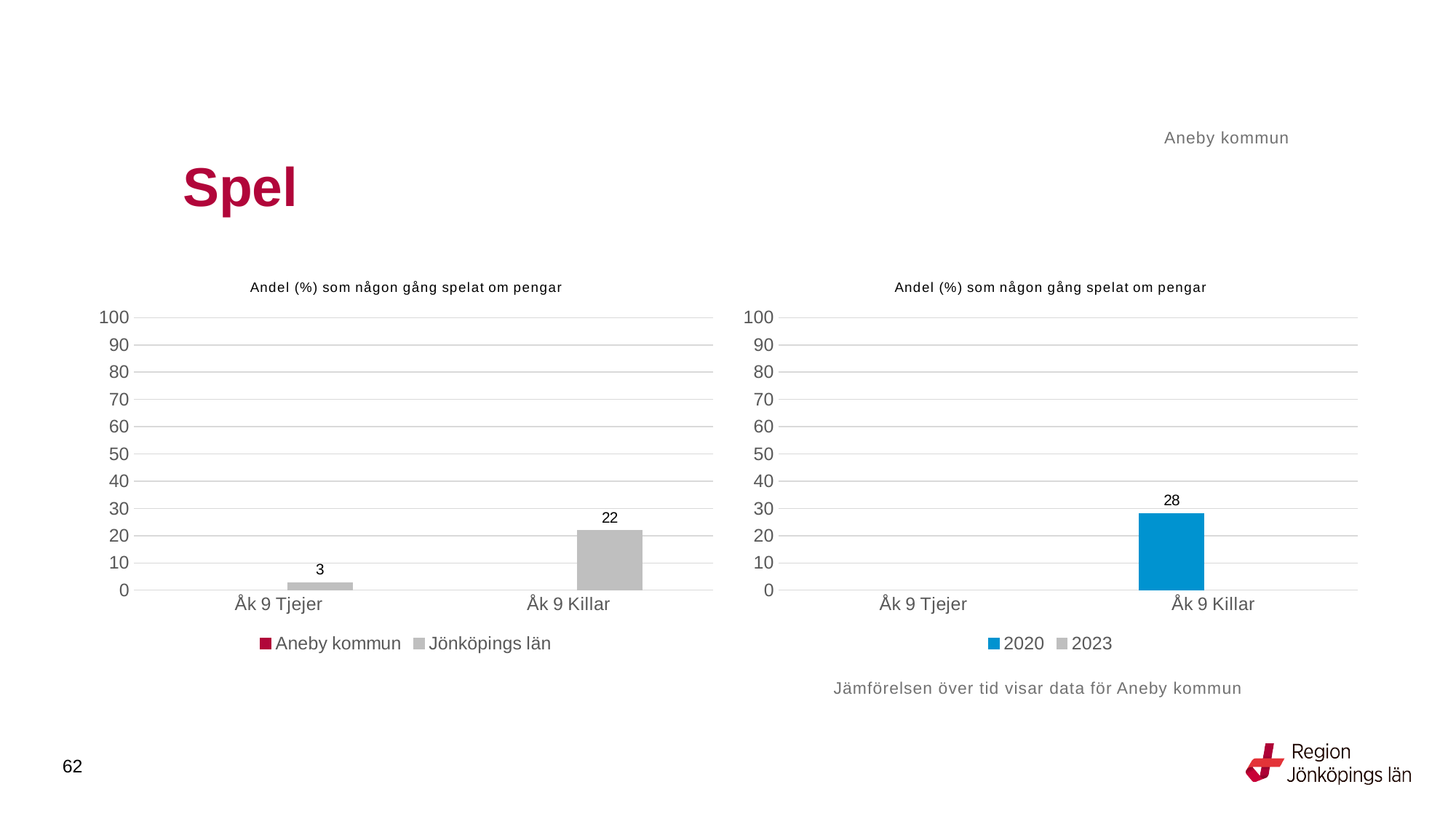
How many categories are shown on the x axis of the left chart? 2 In the left chart, is the Jönköpings län value for Åk 9 Killar greater or less than 30? less In the right chart, is the 2020 value for Åk 9 Killar greater or less than 20? greater What is the title of the right chart? Andel (%) som någon gång spelat om pengar In the right chart, what is the value for 2020 for Åk 9 Killar? 28 What type of chart is the left chart? bar chart In the left chart, which category has the higher Jönköpings län value, Åk 9 Tjejer or Åk 9 Killar? Åk 9 Killar In the left chart, what is the value for Jönköpings län for Åk 9 Killar? 22 In the left chart, what is the difference between the Jönköpings län values for Åk 9 Killar and Åk 9 Tjejer? 19 How many series does the legend of the right chart list? 2 In the left chart, what is the value for Jönköpings län for Åk 9 Tjejer? 3 What are the two series listed in the legend of the left chart? Aneby kommun and Jönköpings län